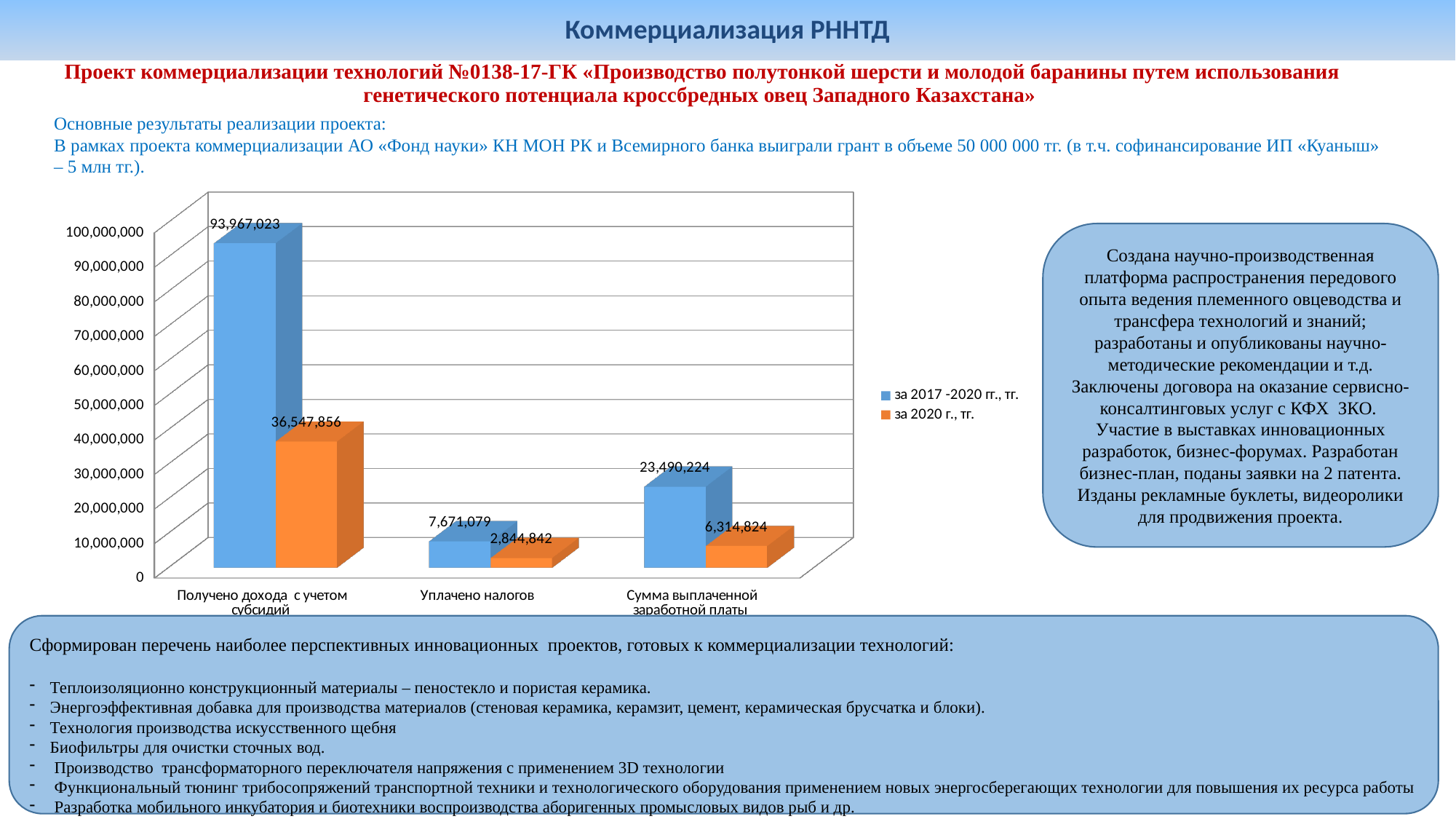
What is the value for "Получено дохода с учетом субсидий" in the series "за 2017 -2020 гг., тг."? 93,967,023 What is the value for "Сумма выплаченной заработной платы" in the series "за 2017 -2020 гг., тг."? 23,490,224 Which category has the lowest value in the series "за 2020 г., тг."? Уплачено налогов Which is larger: the "за 2020 г., тг." value for "Получено дохода с учетом субсидий" or the "за 2017 -2020 гг., тг." value for "Сумма выплаченной заработной платы"? за 2020 г., тг. value for Получено дохода с учетом субсидий What is the value for "Получено дохода с учетом субсидий" in the series "за 2020 г., тг."? 36,547,856 How many categories are shown on the x axis of the chart? 3 Which category has the highest value in the series "за 2017 -2020 гг., тг."? Получено дохода с учетом субсидий What is the difference between the "за 2017 -2020 гг., тг." and "за 2020 г., тг." values for "Получено дохода с учетом субсидий"? 57,419,167 What type of chart is shown on the slide? Bar chart What is the difference between the "за 2017 -2020 гг., тг." and "за 2020 г., тг." values for "Сумма выплаченной заработной платы"? 17,175,400 What is the value for "Уплачено налогов" in the series "за 2020 г., тг."? 2,844,842 How many series does the chart legend list? 2